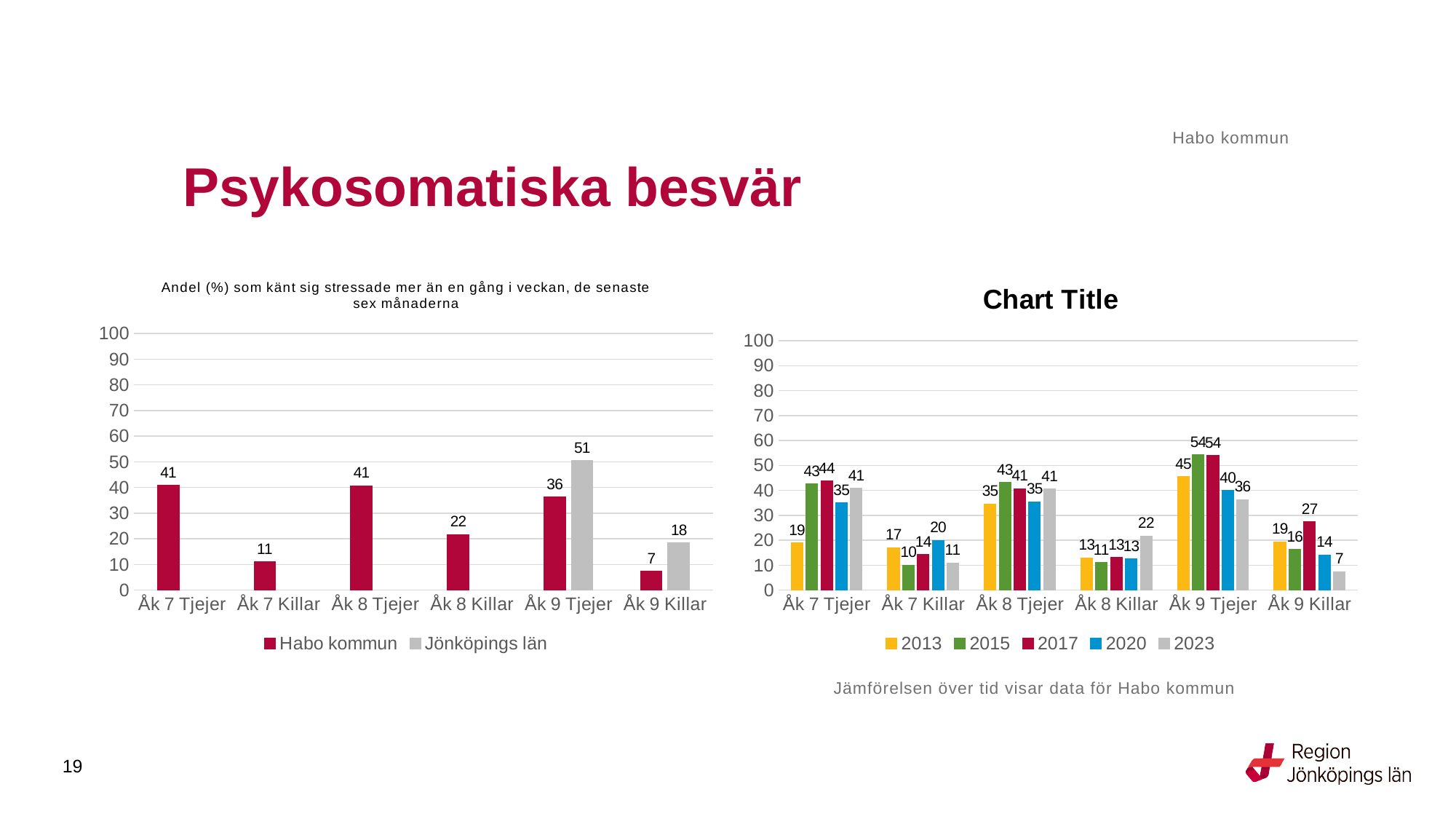
In the chart titled 'Chart Title', what is the value for 2023 for Åk 8 Killar? 22 What kind of chart is the chart titled 'Chart Title'? Bar chart In the left chart, how many series does the legend list? 2 In the chart titled 'Chart Title', what is the value for 2017 for Åk 9 Killar? 27 In the chart titled 'Chart Title', which is larger for Åk 9 Tjejer: the value for 2013 or the value for 2023? 2013 In the left chart, what is the value for Jönköpings län for Åk 9 Tjejer? 51 In the left chart, what is the value for Habo kommun for Åk 8 Killar? 22 In the left chart, is the value for Habo kommun for Åk 7 Tjejer greater or less than 30? greater In the chart titled 'Chart Title', how many series does the legend list? 5 In the chart titled 'Chart Title', which year has the highest value for Åk 7 Killar? 2020 In the left chart, what is the difference between Jönköpings län and Habo kommun for Åk 9 Killar? 11 In the left chart, which category has the lowest value for Habo kommun? Åk 9 Killar